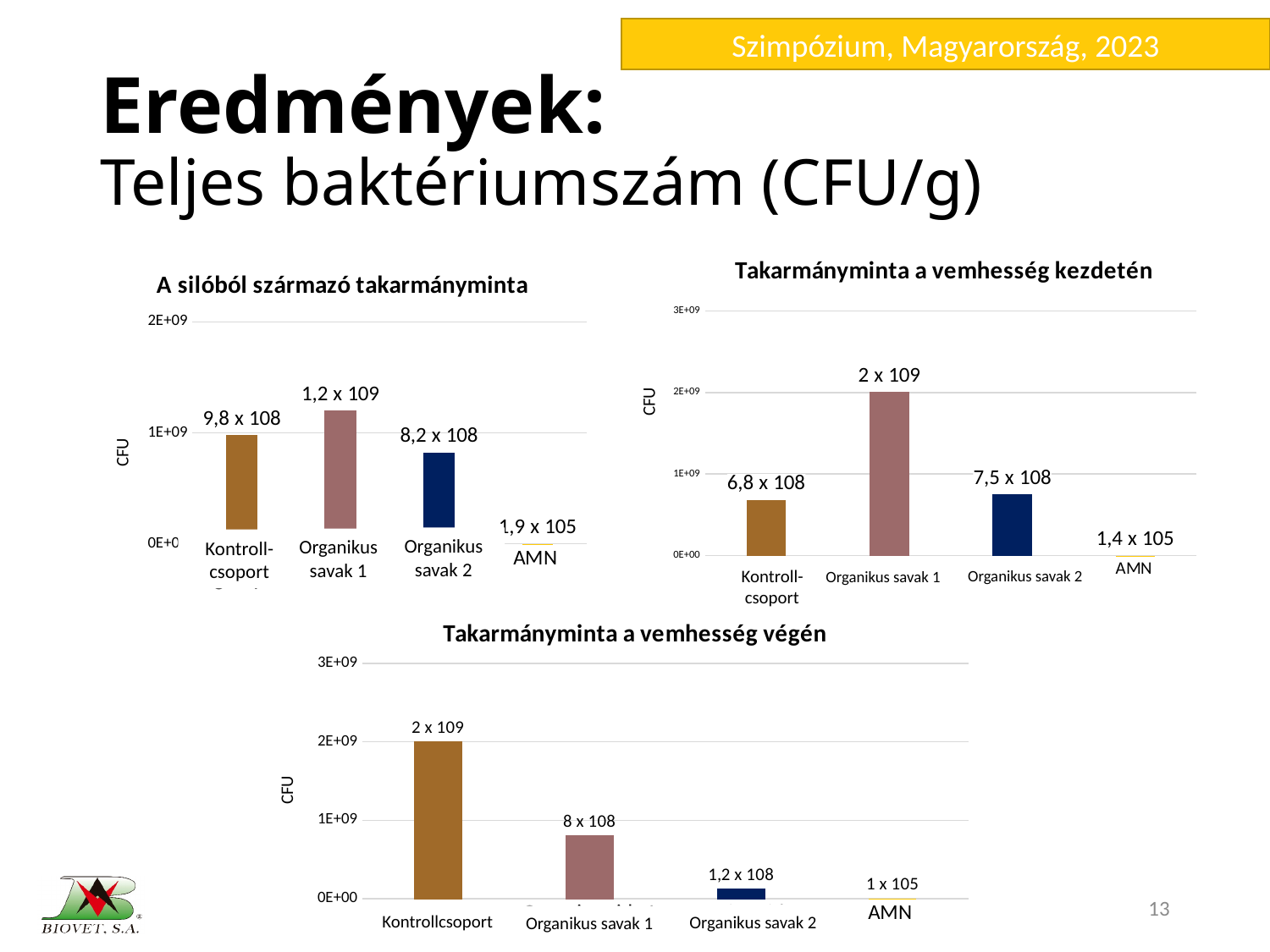
In the chart titled 'Takarmányminta a vemhesség végén', which is larger, Organikus savak 1 or Organikus savak 2? Organikus savak 1 In the chart titled 'Takarmányminta a vemhesség végén', what is the value for Kontrollcsoport? 2 x 109 In the chart titled 'Takarmányminta a vemhesség kezdetén', what is the value for AMN? 1,4 x 105 In the chart titled 'Takarmányminta a vemhesség kezdetén', which category has the highest value? Organikus savak 1 In the chart titled 'Takarmányminta a vemhesség végén', is the value for Organikus savak 1 greater or less than 1E+09? less In the chart titled 'A silóból származó takarmányminta', what is the value for Organikus savak 1? 1,2 x 109 In the chart titled 'A silóból származó takarmányminta', is the value for Organikus savak 1 greater or less than 1E+09? greater In the chart titled 'A silóból származó takarmányminta', which category has the lowest value? AMN What kind of chart is the chart titled 'Takarmányminta a vemhesség kezdetén'? bar chart In the chart titled 'Takarmányminta a vemhesség kezdetén', what is the value for Kontroll-csoport? 6,8 x 108 How many categories are shown in the chart titled 'Takarmányminta a vemhesség végén'? 4 In the chart titled 'A silóból származó takarmányminta', which category has the highest value? Organikus savak 1